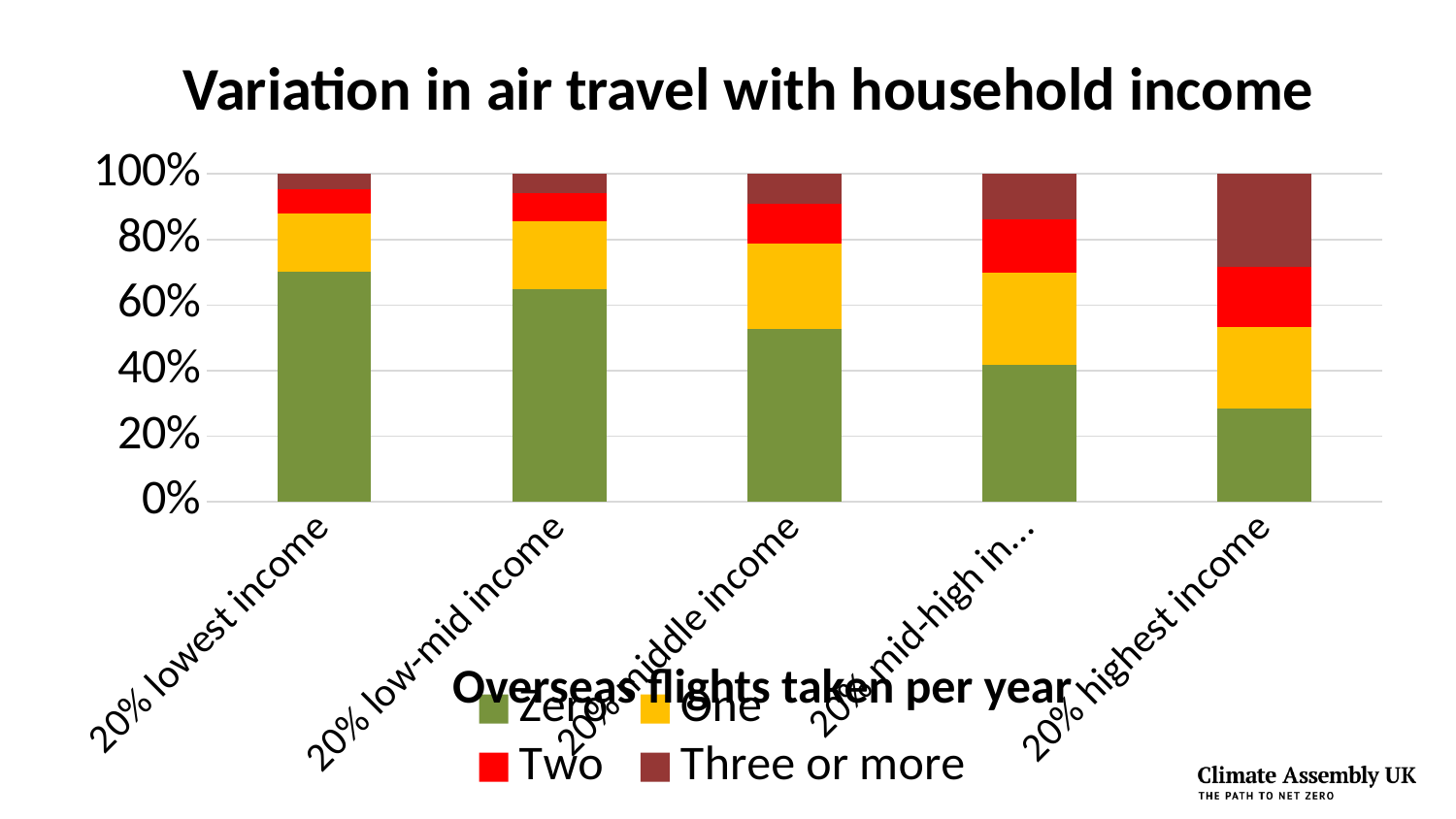
Which is larger: the 'Zero' segment for 20% lowest income or for 20% highest income? 20% lowest income Which income category has the smallest 'Zero' segment? 20% highest income Does the 'Zero' share rise or fall as household income increases from left to right? Fall What is the title of the chart? Variation in air travel with household income Which income category has the largest 'Zero' segment? 20% lowest income How many series does the legend list? 4 Is the 'Zero' segment for 20% lowest income greater or less than 60%? greater What kind of chart is shown on the slide? Stacked bar chart Which series is shown in green in the legend? Zero How many income categories are shown along the x axis? 5 Is the 'Zero' segment for 20% highest income greater or less than 40%? less What is the total height of each stacked bar? 100%